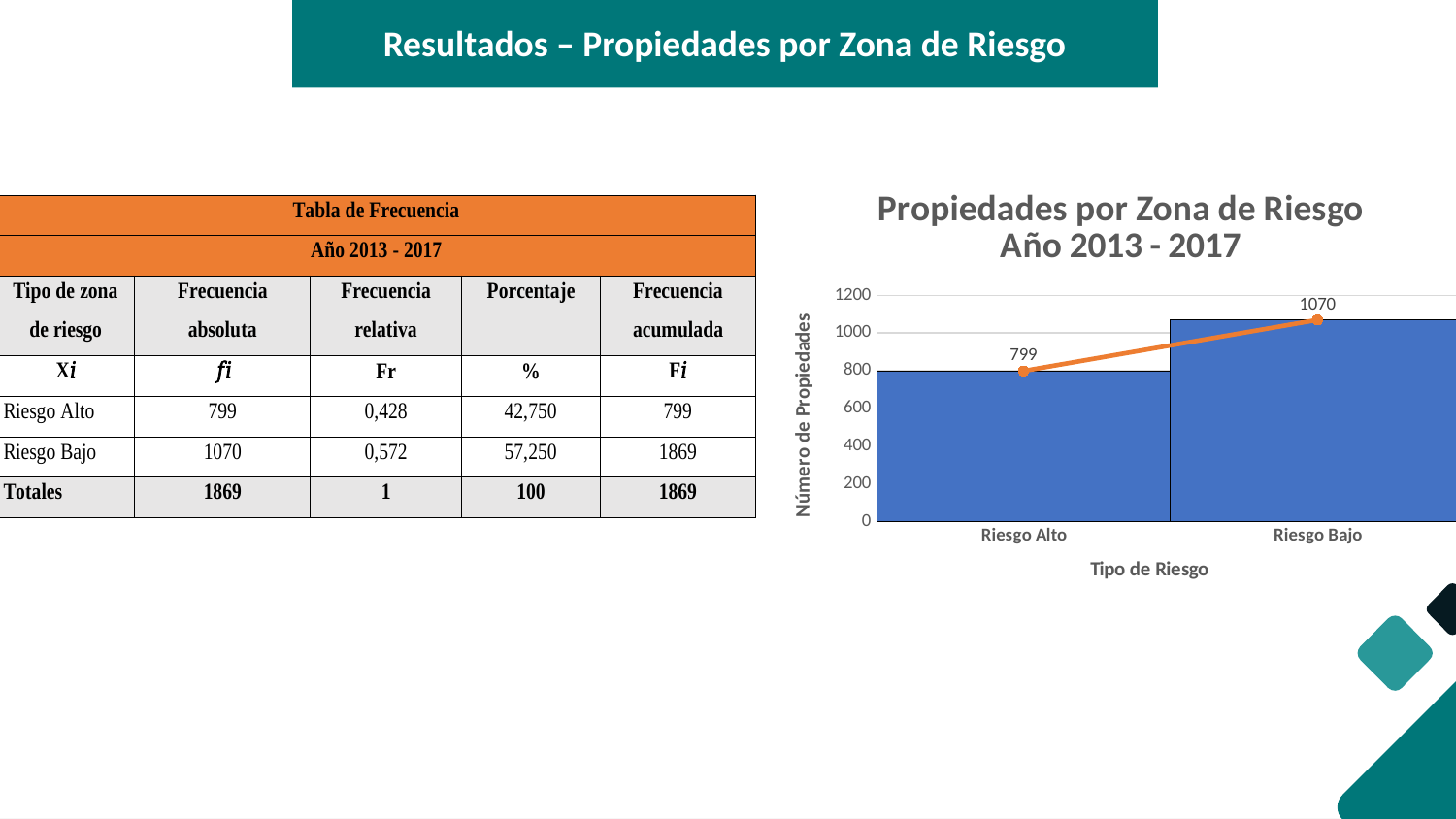
Which is larger in the chart, the value for Riesgo Alto or the value for Riesgo Bajo? Riesgo Bajo Is the value for Riesgo Alto greater or less than 1000? less What is the value for Riesgo Alto in the chart? 799 What kind of chart is shown on the slide? combination bar and line chart What is the label of the vertical axis of the chart? Número de Propiedades What is the difference between the values for Riesgo Bajo and Riesgo Alto in the chart? 271 How many categories are shown on the x axis of the chart? 2 Which category has the lowest value in the chart? Riesgo Alto Is the value for Riesgo Bajo greater or less than 1000? greater Which category has the highest value in the chart? Riesgo Bajo What is the value for Riesgo Bajo in the chart? 1070 What is the title of the chart? Propiedades por Zona de Riesgo Año 2013 - 2017